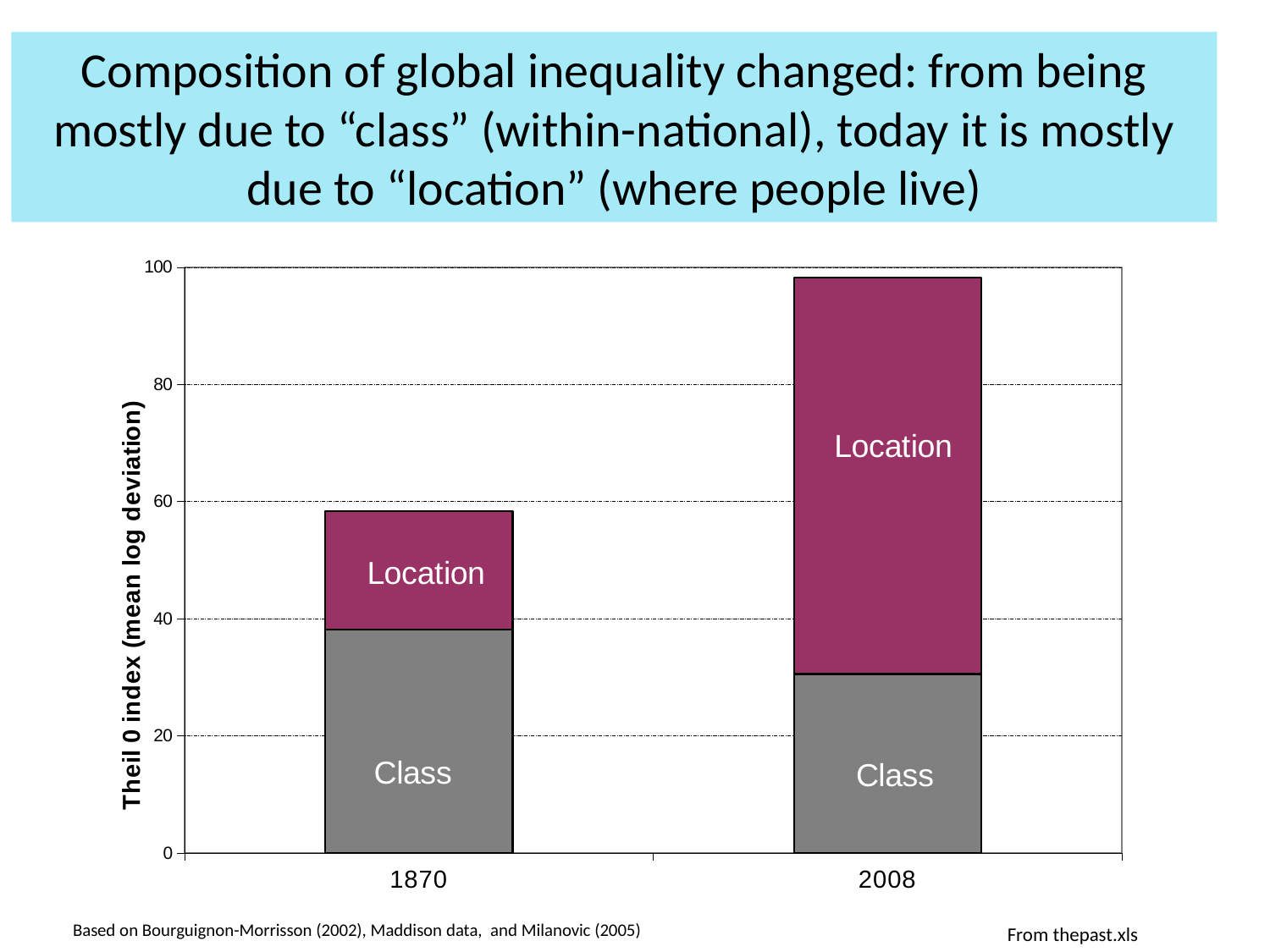
Is the Class component for 2008 greater or less than 40? less How many components (series) make up each stacked bar in the chart? 2 Is the Class component larger in 1870 or in 2008? 1870 Is the total bar for 2008 greater or less than 80? greater Is the total bar for 1870 greater or less than 40? greater Which year has the taller total bar, 1870 or 2008? 2008 How many years (categories) are shown on the x axis of the chart? 2 What kind of chart is shown on the slide? Stacked bar chart What is the title of the y axis of the chart? Theil 0 index (mean log deviation) Does the total Theil 0 index rise or fall from 1870 to 2008? Rise In 2008, which component is larger, Class or Location? Location In 1870, which component is larger, Class or Location? Class